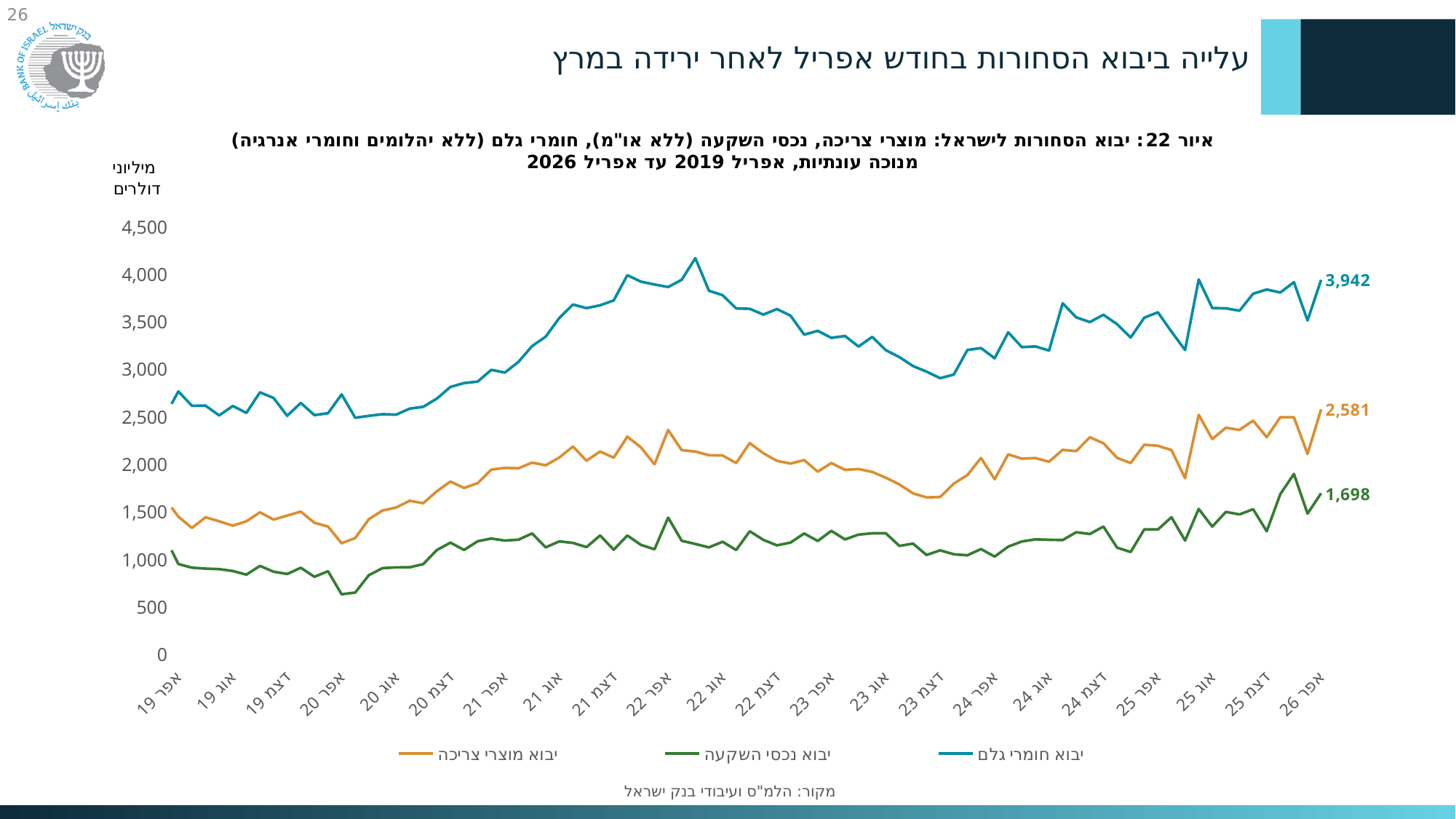
Which series has the lowest value at the end of the chart (אפר 26)? יבוא נכסי השקעה What is the value of the יבוא מוצרי צריכה series at the last point (אפר 26)? 2,581 What is the value of the יבוא נכסי השקעה series at the last point (אפר 26)? 1,698 How many series does the legend list? 3 Is the value of יבוא חומרי גלם at אפר 19 greater or less than 2,500? greater Which series has the highest value at the end of the chart (אפר 26)? יבוא חומרי גלם What is the difference between the final values of יבוא מוצרי צריכה and יבוא נכסי השקעה? 883 What kind of chart is shown on the slide? line chart What unit is shown on the y axis of the chart? מיליוני דולרים What is the value of the יבוא חומרי גלם series at the last point (אפר 26)? 3,942 What is the difference between the final values of יבוא חומרי גלם and יבוא מוצרי צריכה? 1,361 Is the value of יבוא נכסי השקעה at אפר 19 greater or less than 1,500? less